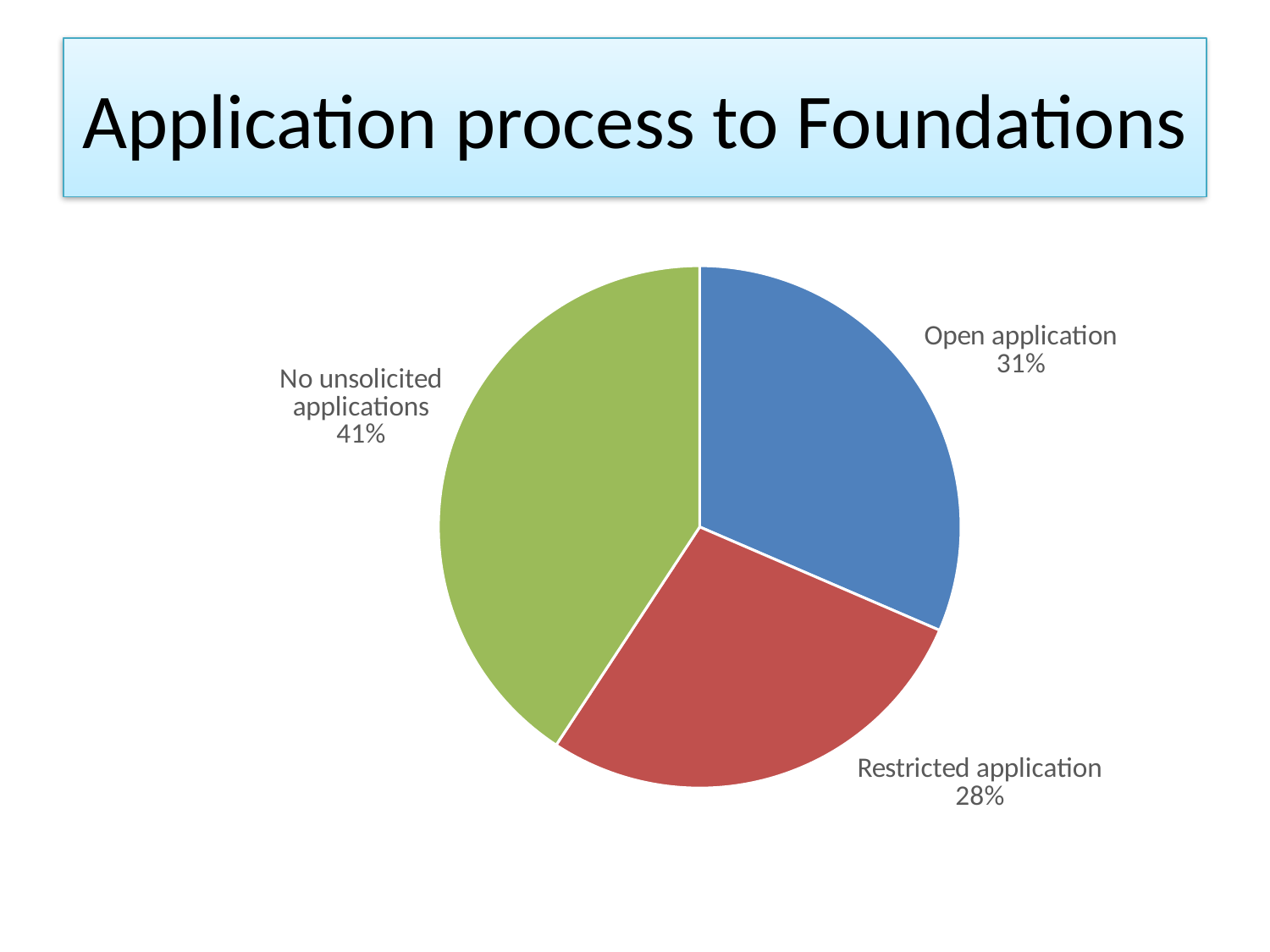
How many slices does the pie chart have? 3 What share of the pie is labelled 'Open application'? 31% What share of the pie is labelled 'Restricted application'? 28% What is the difference in percentage points between 'No unsolicited applications' and 'Open application'? 10 Which category has the largest slice of the pie? No unsolicited applications What kind of chart is shown on the slide? Pie chart What share of the pie is labelled 'No unsolicited applications'? 41% What is the difference in percentage points between 'Open application' and 'Restricted application'? 3 Which category has the smallest slice of the pie? Restricted application Which is larger, the 'Open application' slice or the 'Restricted application' slice? Open application What is the title of the slide? Application process to Foundations What colour is the 'No unsolicited applications' slice? Green